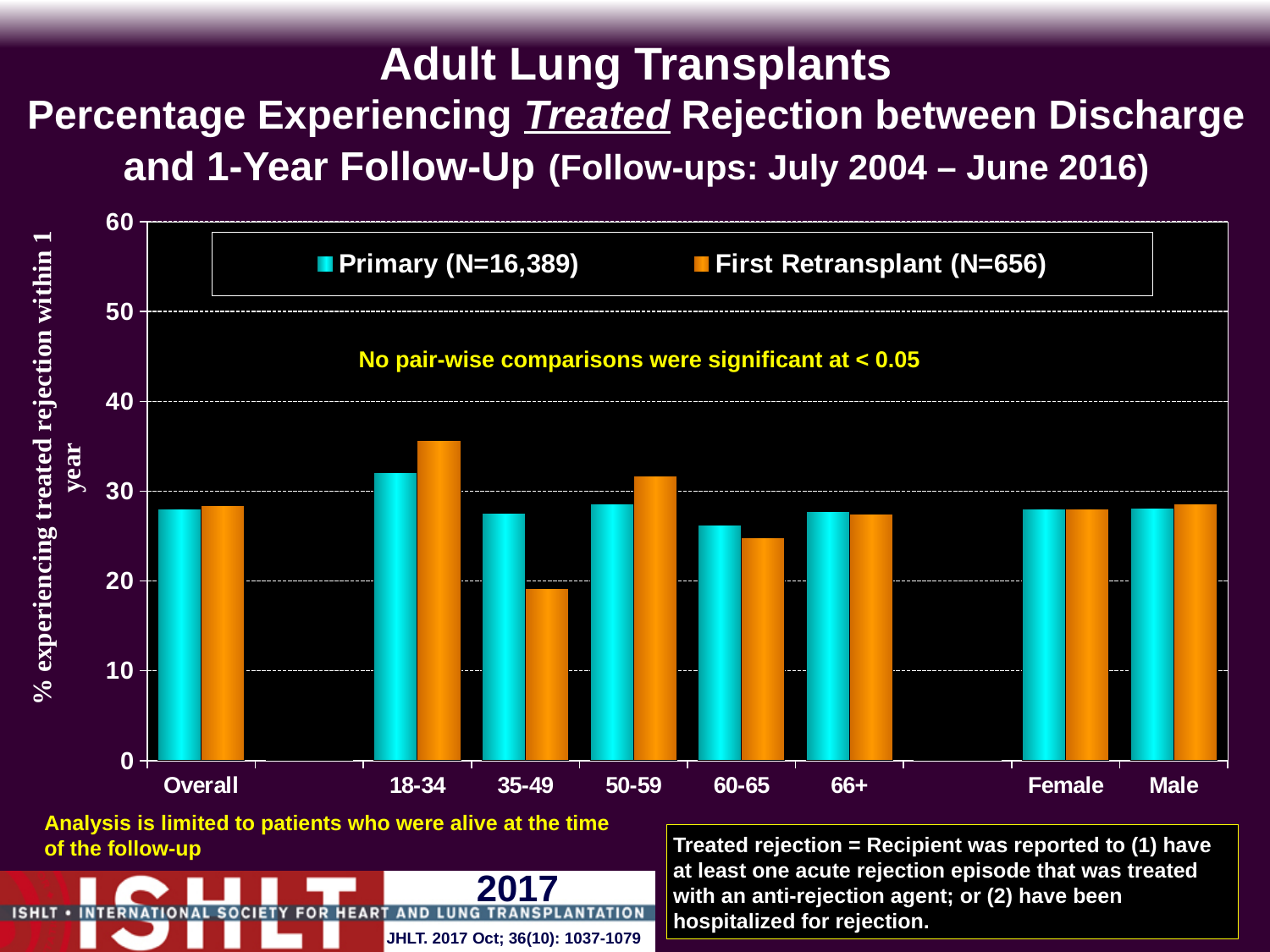
Is the Primary value for Overall greater or less than 30? less Is the First Retransplant value for 35-49 greater or less than 20? less Which category has the highest value for the Primary (N=16,389) series? 18-34 For the 35-49 category, which series has the larger value, Primary or First Retransplant? Primary Which category has the highest value for the First Retransplant (N=656) series? 18-34 What kind of chart is shown on the slide? bar chart How many categories are shown along the x axis? 8 Is the First Retransplant value for 18-34 greater or less than 30? greater Which category has the lowest value for the First Retransplant (N=656) series? 35-49 For the 50-59 category, which series has the larger value, Primary or First Retransplant? First Retransplant How many series does the legend list? 2 What is the sample size (N) given in the legend for the Primary series? 16,389